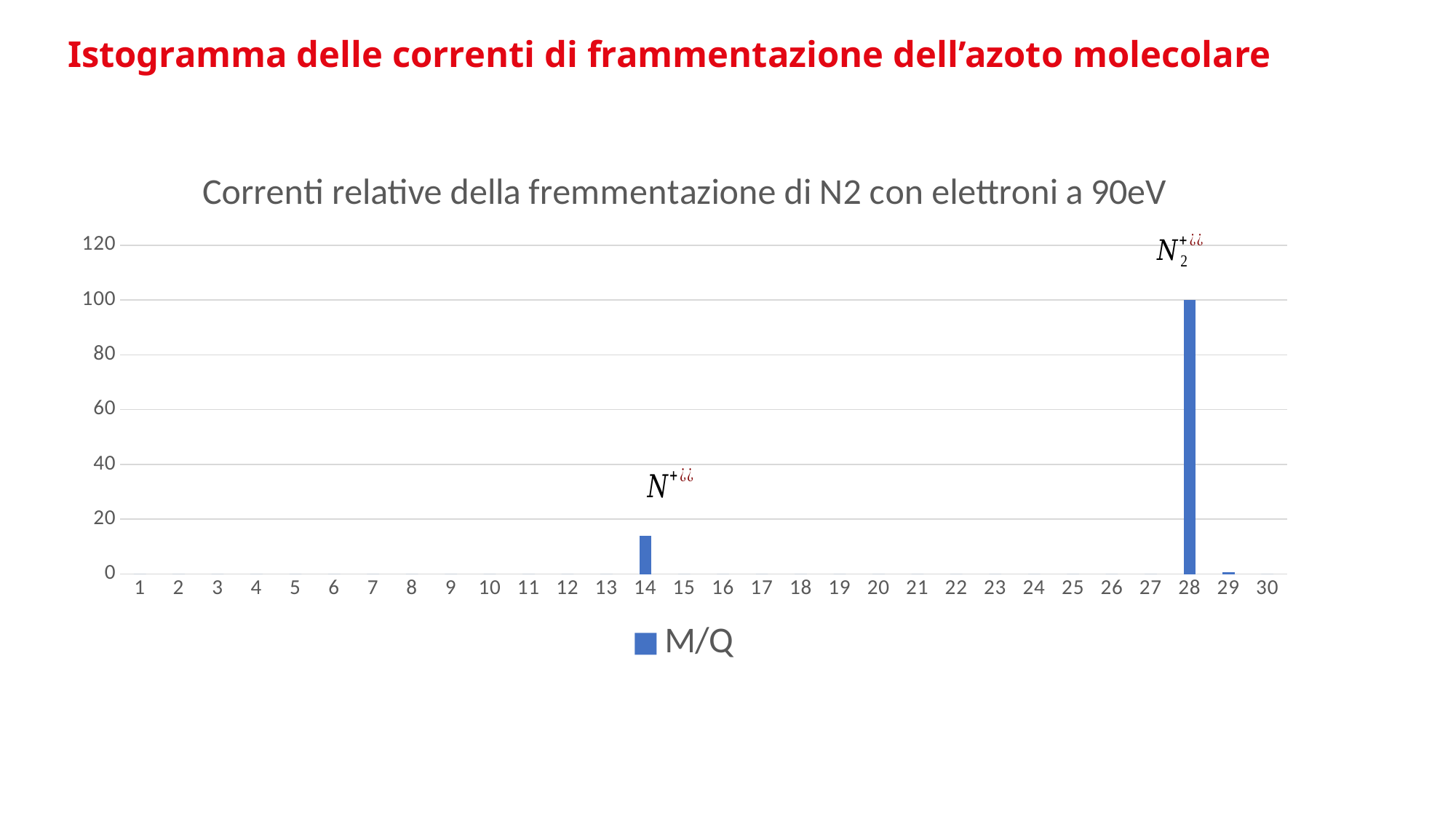
How many categories are shown on the x axis? 30 Which category has the highest value? 28 Is the value for category 29 greater or less than 20? less Which is larger, the value for category 14 or the value for category 28? 28 What is the title of the chart? Correnti relative della fremmentazione di N2 con elettroni a 90eV Is the value for category 28 greater or less than 80? greater How many series does the legend list? 1 What is the value for category 28? 100 What is the name of the series in the legend? M/Q What kind of chart is shown on the slide? bar chart Which is larger, the value for category 14 or the value for category 29? 14 Is the value for category 14 greater or less than 20? less